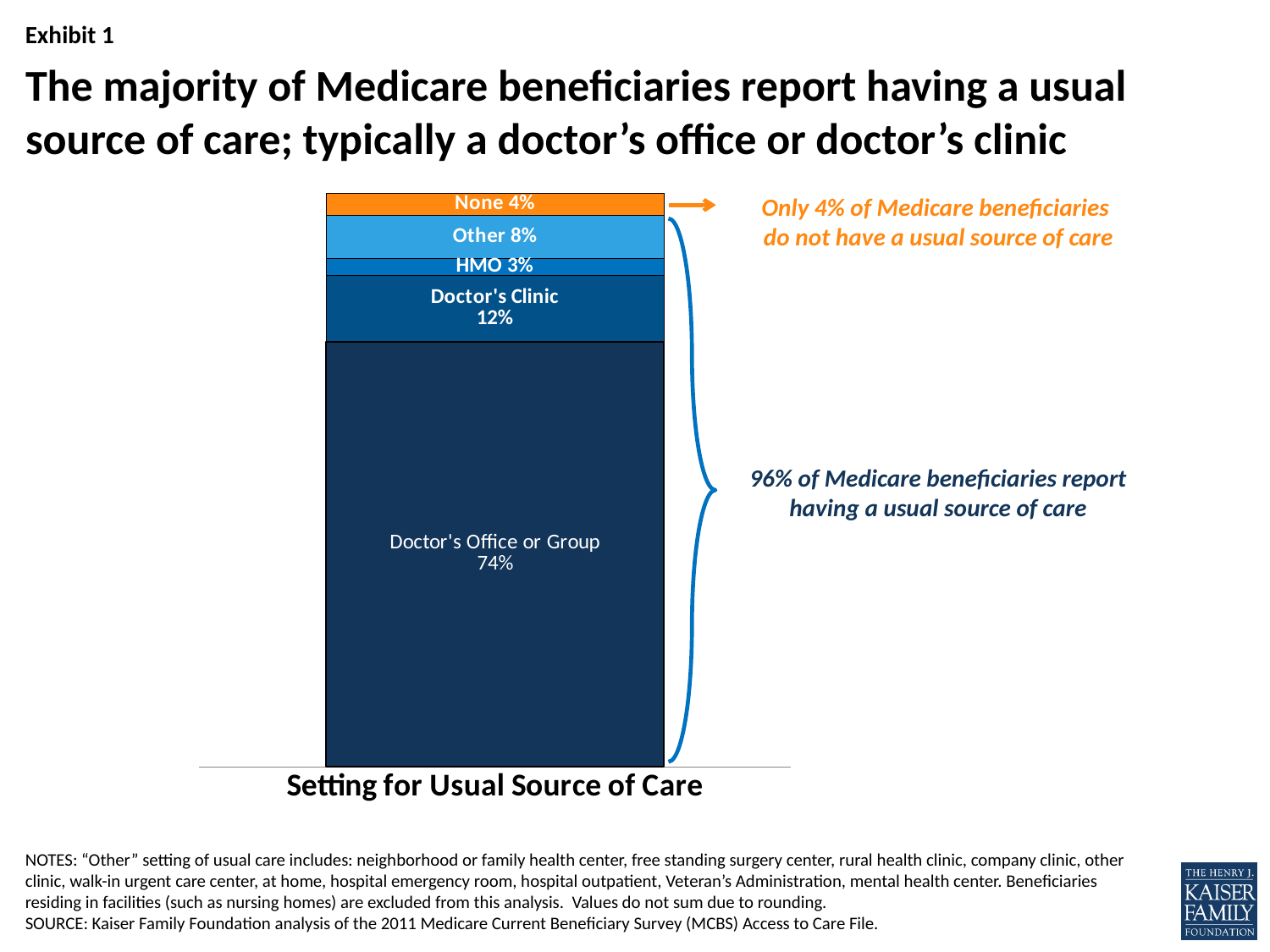
What percentage of Medicare beneficiaries report an HMO as their usual source of care? 3% Which setting for usual source of care has the largest share? Doctor's Office or Group What percentage of Medicare beneficiaries report having no usual source of care? 4% What is the label on the x axis of the chart? Setting for Usual Source of Care What kind of chart is shown on the slide? Stacked bar chart Which is larger, the share for Other or the share for None? Other How many segments make up the stacked bar? 5 What percentage of Medicare beneficiaries report a doctor's clinic as their usual source of care? 12% What is the difference in percentage points between Doctor's Office or Group and Doctor's Clinic? 62 Which setting for usual source of care has the smallest share? HMO What percentage of Medicare beneficiaries report 'Other' as their setting for usual source of care? 8% What percentage of Medicare beneficiaries report a doctor's office or group as their usual source of care? 74%